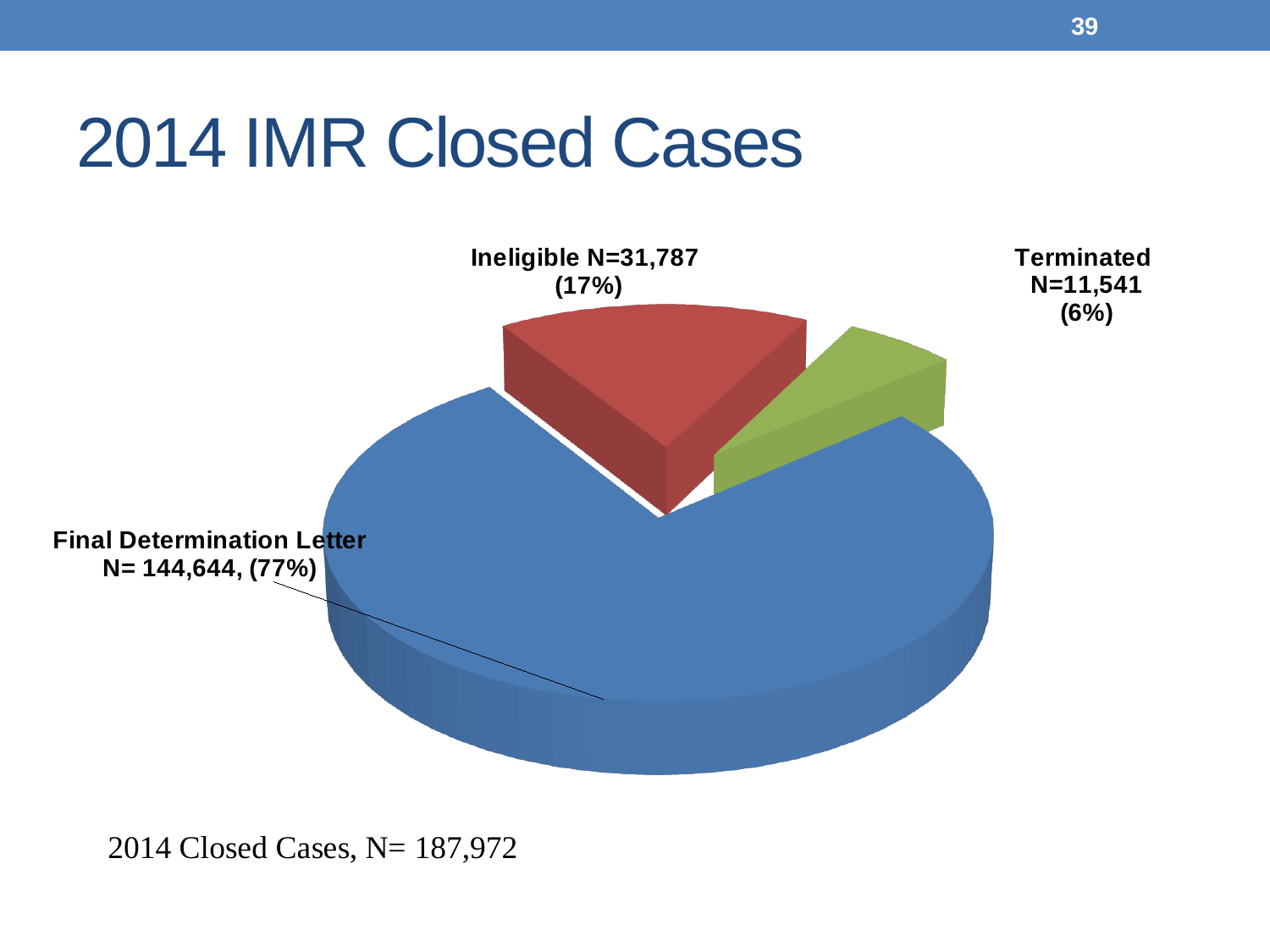
What is the N value for the Final Determination Letter slice? 144,644 What colour is the Terminated slice? Green What share of the pie does the Ineligible slice represent? 17% Which category has the largest slice? Final Determination Letter What is the difference in N between the Ineligible and Terminated slices? 20,246 How many slices does the pie chart have? 3 What share of the pie does the Final Determination Letter slice represent? 77% What is the N value for the Ineligible slice? 31,787 Which category has the smallest slice? Terminated What is the N value for the Terminated slice? 11,541 What share of the pie does the Terminated slice represent? 6% What kind of chart is shown on the slide? Pie chart